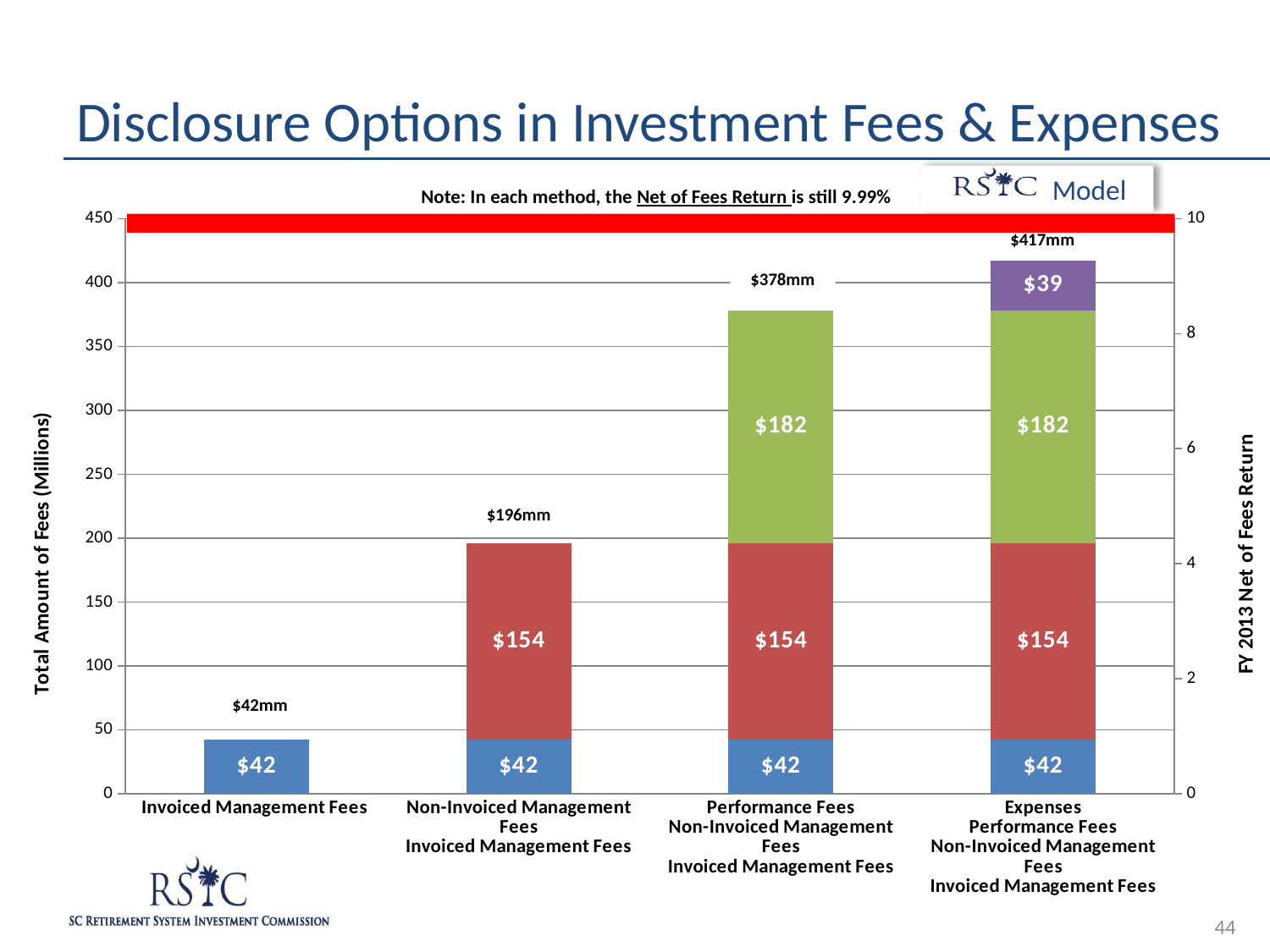
What is the total value labelled above the third bar (Performance Fees)? $378mm Is the total for the second bar (Non-Invoiced Management Fees) greater or less than 200? less Do the bar totals rise or fall from left to right across the chart? Rise What is the total value labelled above the fourth bar (Expenses)? $417mm Which bar has the highest total? Expenses (fourth bar) What is the value of the green segment in the third bar (Performance Fees)? $182 How many bars are shown in the chart? 4 What is the difference between the total of the fourth bar ($417mm) and the total of the third bar ($378mm)? $39mm Which is larger: the total of the second bar (Non-Invoiced Management Fees) or the total of the third bar (Performance Fees)? Performance Fees (third bar) What kind of chart is shown on the slide? Stacked bar chart Which bar has the lowest total? Invoiced Management Fees What is the value of the purple segment in the fourth bar (Expenses)? $39